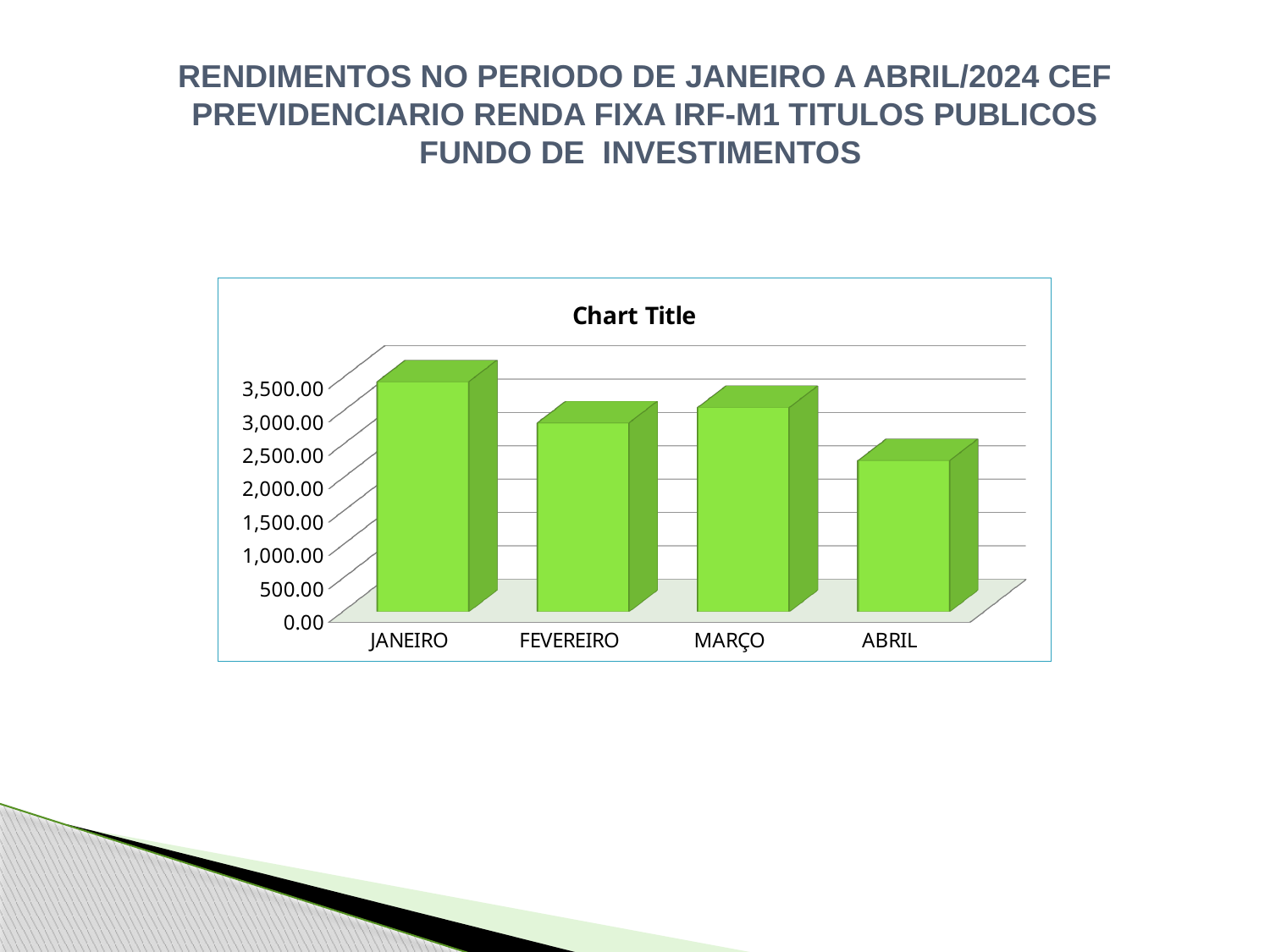
What kind of chart is shown on the slide? bar chart Is the value for MARÇO greater or less than 2,500.00? greater Is the value for ABRIL greater or less than 2,000.00? greater Is the value for FEVEREIRO greater or less than 2,500.00? greater Which month has the lowest bar in the chart? ABRIL How many categories are shown on the x axis of the chart? 4 What is the title printed above the plot area of the chart? Chart Title Which is larger, the value for JANEIRO or the value for FEVEREIRO? JANEIRO Which month has the highest bar in the chart? JANEIRO Which is larger, the value for MARÇO or the value for ABRIL? MARÇO